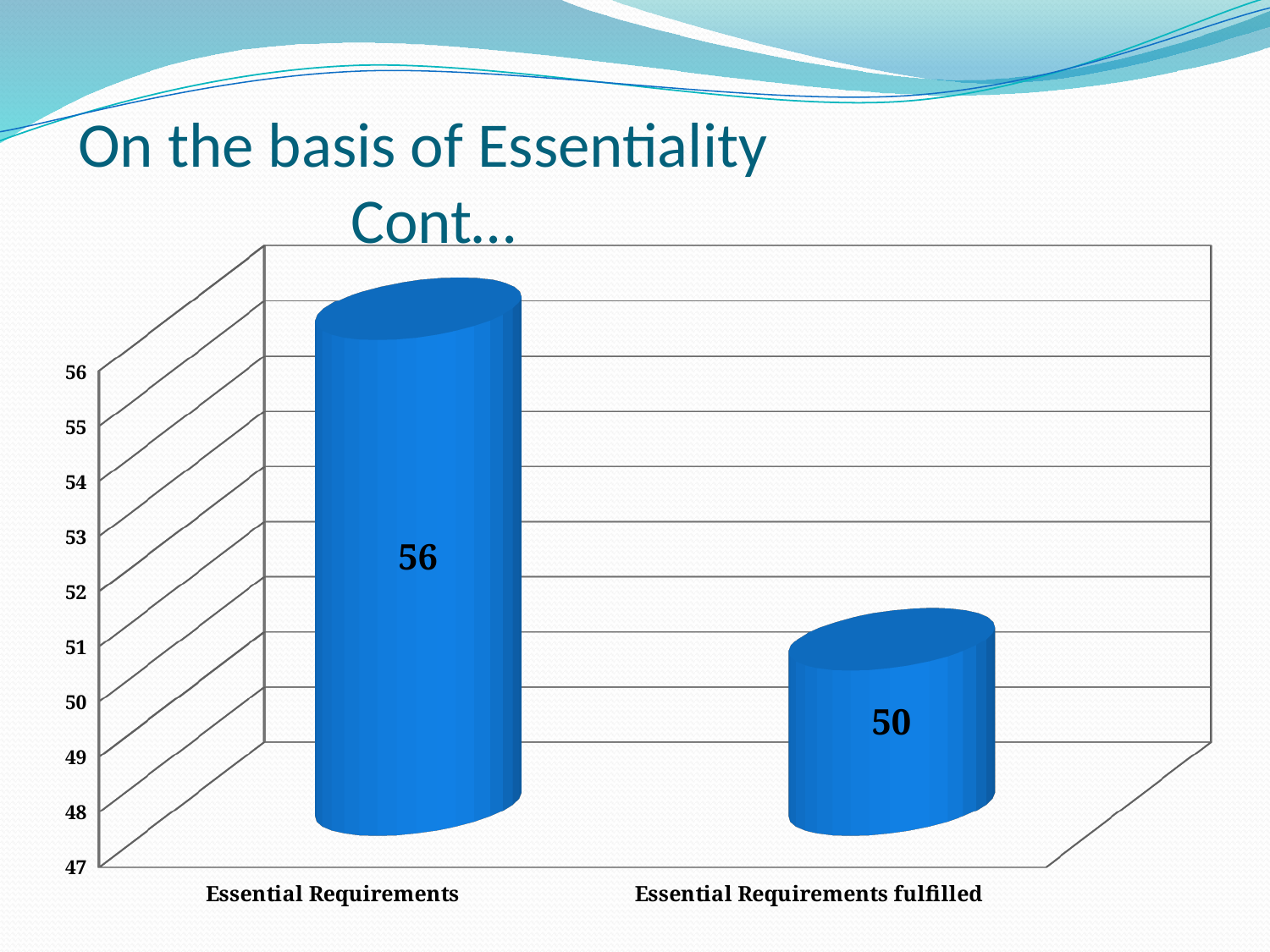
Is the value for Essential Requirements fulfilled greater or less than 53? less What is the value for Essential Requirements? 56 Which is larger: the value for Essential Requirements or the value for Essential Requirements fulfilled? Essential Requirements How many categories are shown on the chart? 2 What is the title of the slide? On the basis of Essentiality Cont... Do the values rise or fall from left to right along the x axis? fall Which category has the lowest value? Essential Requirements fulfilled What is the value for Essential Requirements fulfilled? 50 Is the value for Essential Requirements greater or less than 52? greater What is the difference between the value for Essential Requirements and the value for Essential Requirements fulfilled? 6 What kind of chart is shown on the slide? bar chart Which category has the highest value? Essential Requirements